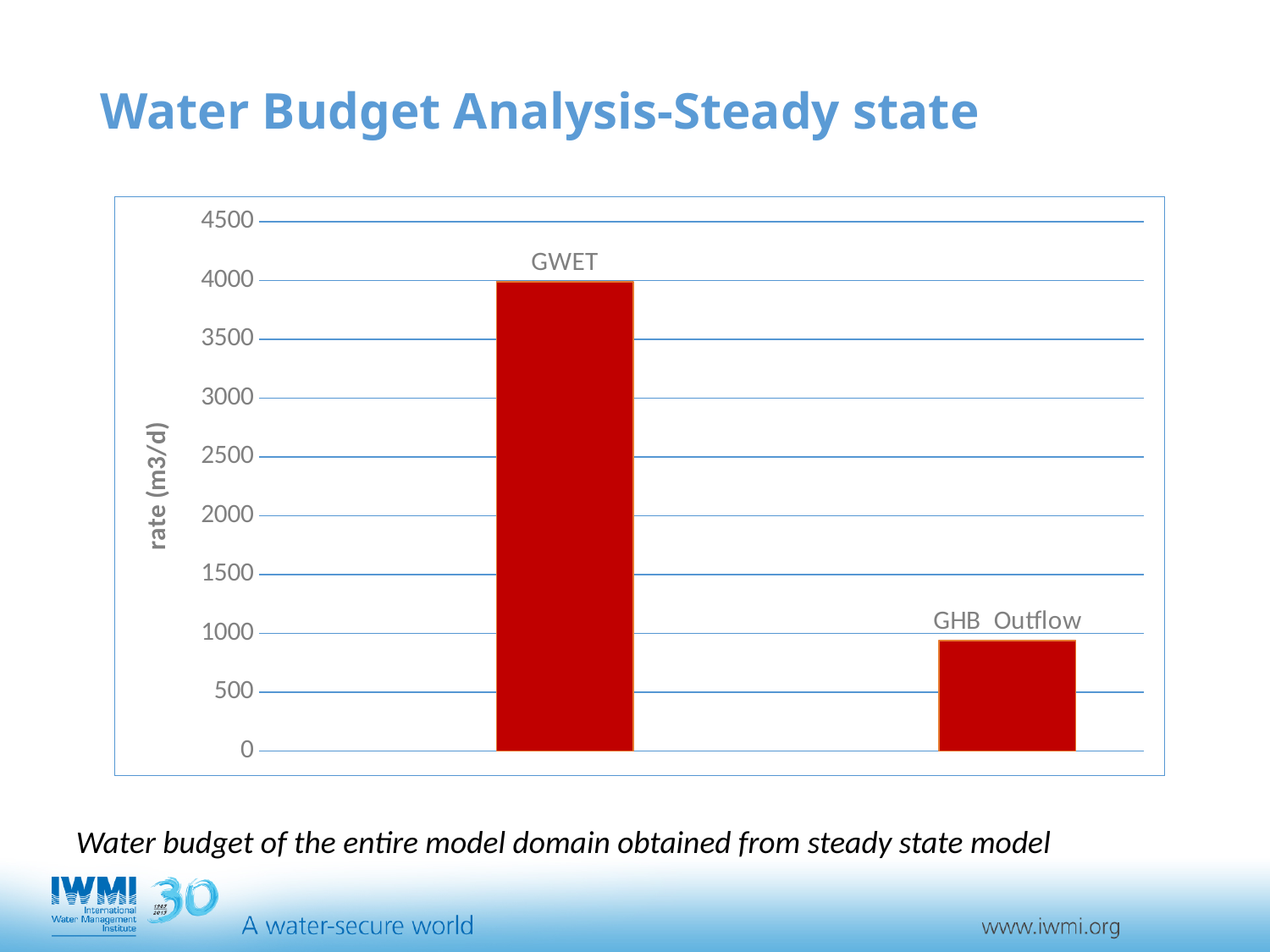
What is the label of the vertical axis of the chart? rate (m3/d) Which category has the lowest value in the chart? GHB Outflow How many bars (categories) are plotted in the chart? 2 Which is larger, the value for GWET or the value for GHB Outflow? GWET Is the value for GHB Outflow greater or less than 1500? less Is the value for GWET greater or less than 4500? less Is the value for GWET greater or less than 3500? greater What colour are the bars in the chart? red Which category has the highest value in the chart? GWET What type of chart is shown on the slide? bar chart